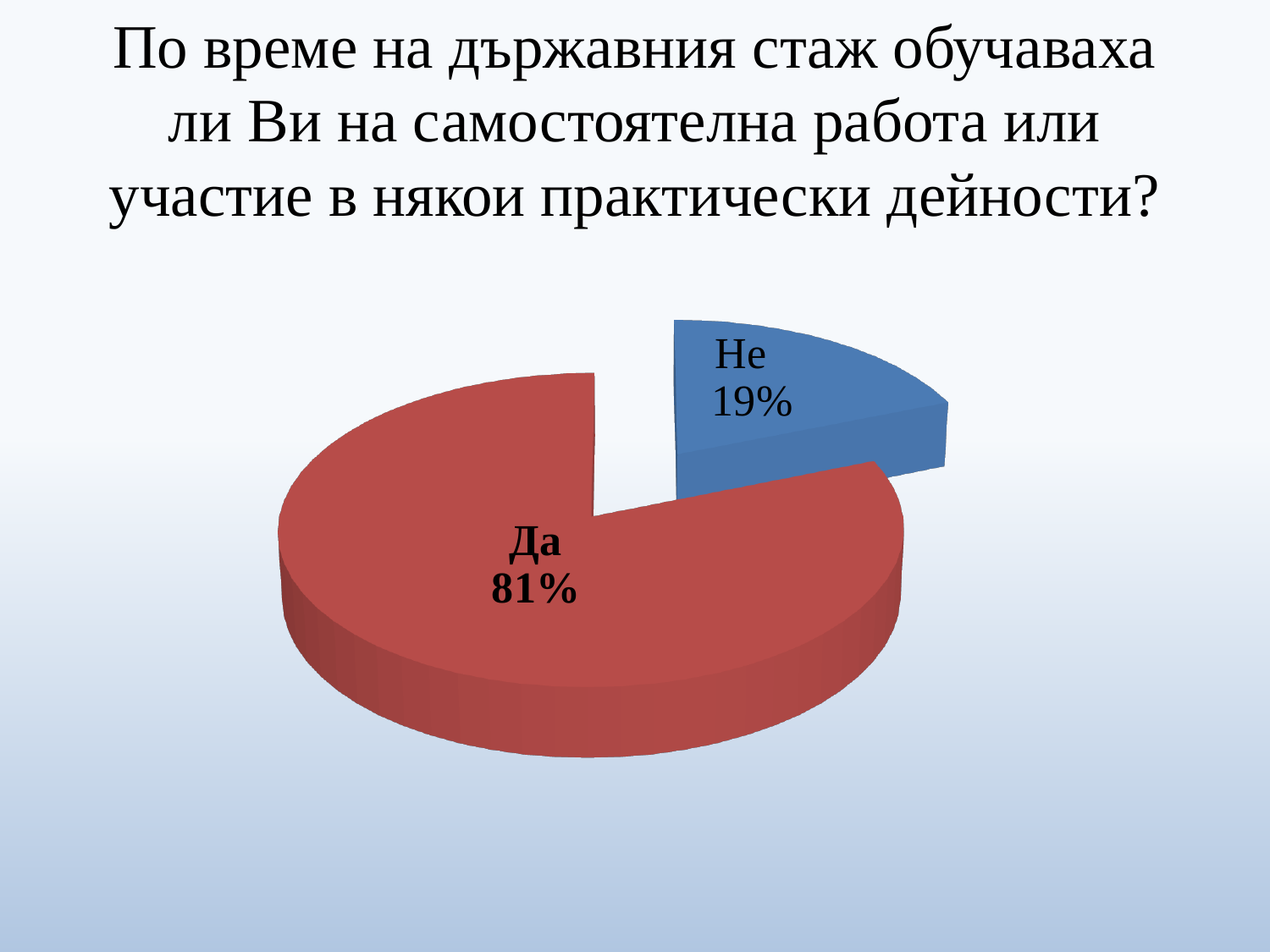
What share of the pie does the "Не" slice represent? 19% Which slice is larger, "Да" or "Не"? Да What is the difference in percentage points between the "Да" and "Не" slices? 62 Which slice of the pie is the smallest? Не What colour is the "Да" slice? red How many slices does the pie chart have? 2 What percentage of the pie is labelled "Не"? 19% Which slice of the pie is the largest? Да What colour is the "Не" slice? blue What kind of chart is shown on the slide? pie chart What percentage of the pie is labelled "Да"? 81%